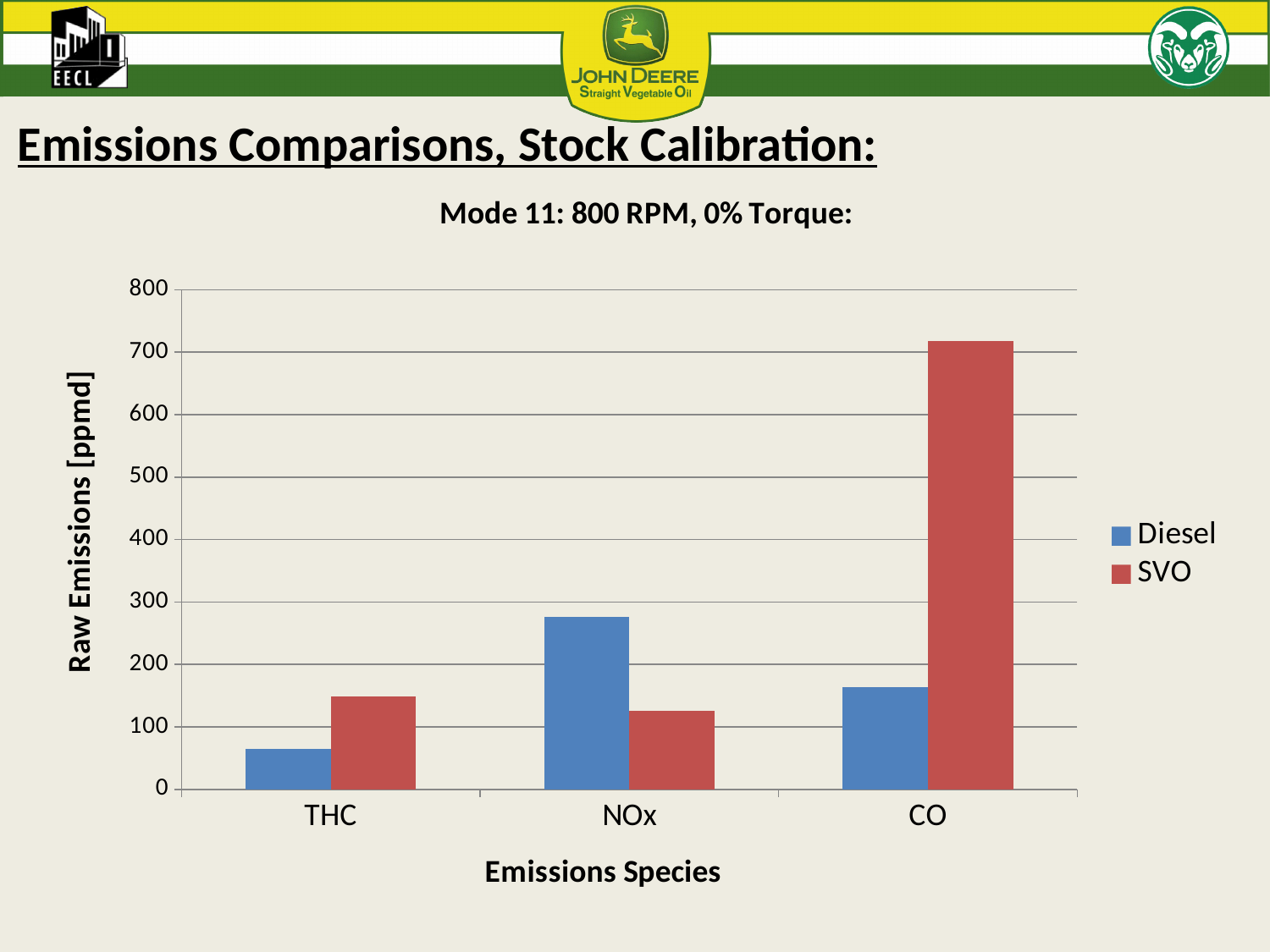
For CO, which is larger, the Diesel value or the SVO value? SVO Is the Diesel value for THC greater or less than 100? less What is the label of the y axis? Raw Emissions [ppmd] For which emissions species is the SVO value highest? CO How many series does the legend list? 2 For which emissions species is the Diesel value highest? NOx For NOx, which is larger, the Diesel value or the SVO value? Diesel Is the Diesel value for NOx greater or less than 200? greater What kind of chart is shown on the slide? bar chart For which emissions species is the Diesel value lowest? THC How many emissions species categories are shown on the x axis? 3 Is the SVO value for CO greater or less than 700? greater